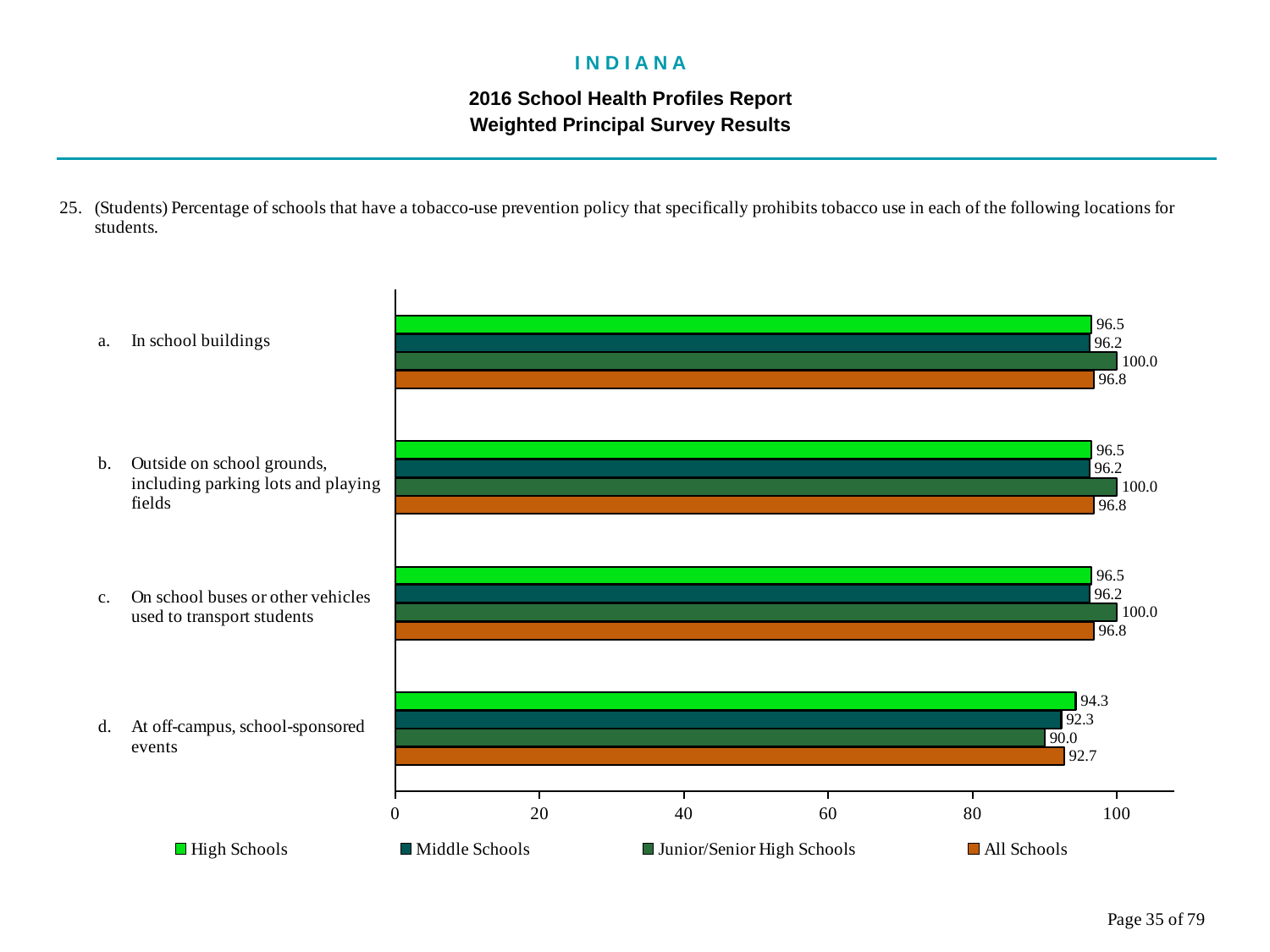
Which series has the highest value for 'Outside on school grounds, including parking lots and playing fields'? Junior/Senior High Schools How many location categories are shown on the chart? 4 What is the difference between the High Schools and Junior/Senior High Schools values for 'At off-campus, school-sponsored events'? 4.3 What is the value for Middle Schools for 'At off-campus, school-sponsored events'? 92.3 Which is larger for 'In school buildings': the High Schools value or the Middle Schools value? High Schools Which series has the lowest value for 'At off-campus, school-sponsored events'? Junior/Senior High Schools What is the value for High Schools for 'At off-campus, school-sponsored events'? 94.3 How many series does the legend list? 4 What kind of chart is shown on the slide? Bar chart What is the value for All Schools for 'On school buses or other vehicles used to transport students'? 96.8 What is the value for Junior/Senior High Schools for 'In school buildings'? 100.0 Which colour represents All Schools in the legend? Orange